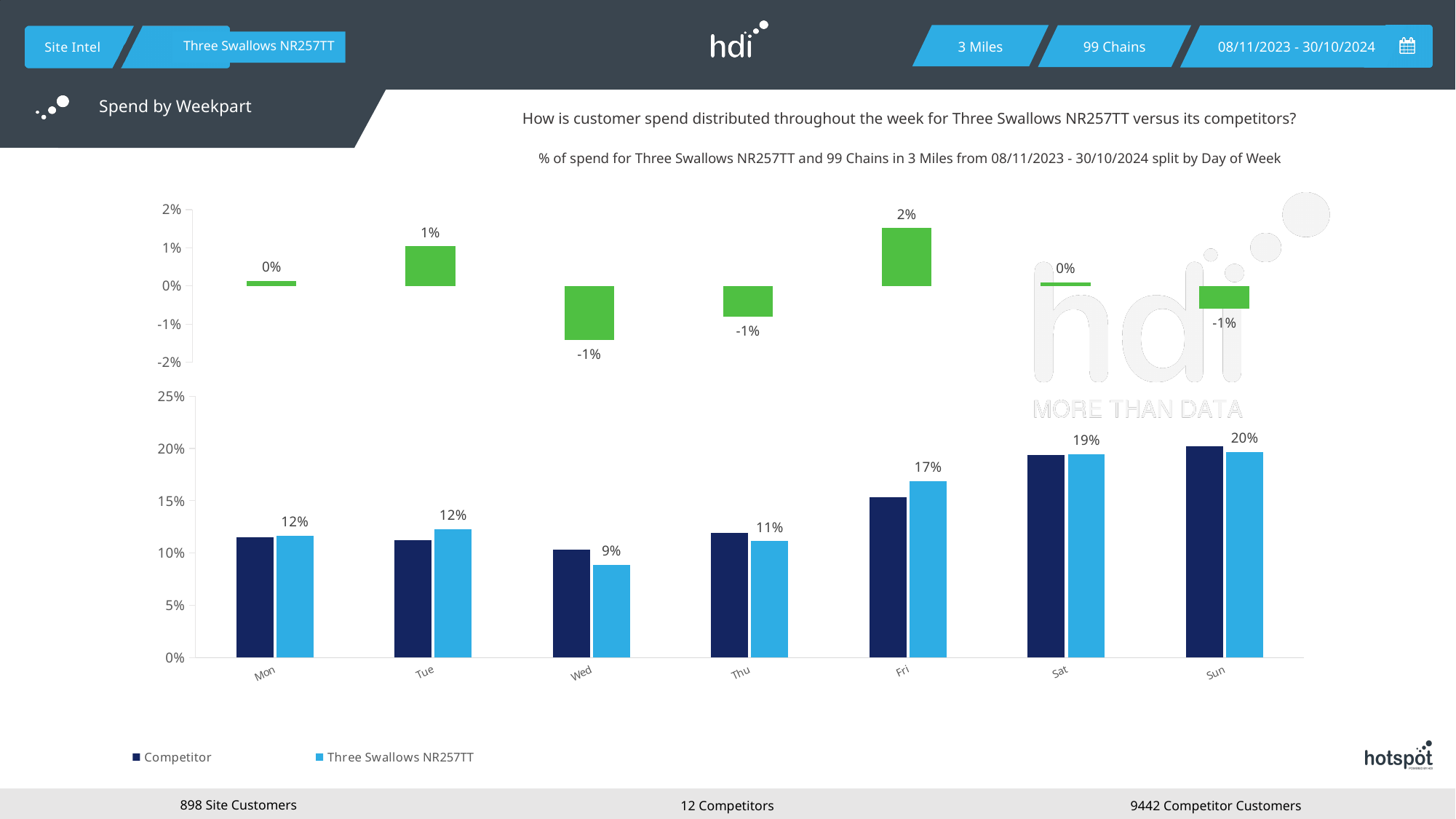
In the bottom chart, which is larger on Wed: the Competitor bar or the Three Swallows NR257TT bar? Competitor In the bottom chart, which day has the lowest value for Three Swallows NR257TT? Wed How many series does the legend of the bottom chart list? 2 In the bottom chart, is the Competitor value for Sat greater or less than 15%? greater In the bottom chart, which day has the highest value for Three Swallows NR257TT? Sun In the bottom chart, what is the value for Three Swallows NR257TT on Fri? 17% In the top chart, what is the value shown for Fri? 2% In the bottom chart, what is the value for Three Swallows NR257TT on Wed? 9% How many days of the week are shown on the x axis of the bottom chart? 7 What kind of chart is the bottom chart? bar chart In the bottom chart, is the Competitor value for Wed greater or less than 15%? less In the bottom chart, what is the difference between the Three Swallows NR257TT values for Sun and Wed? 11%